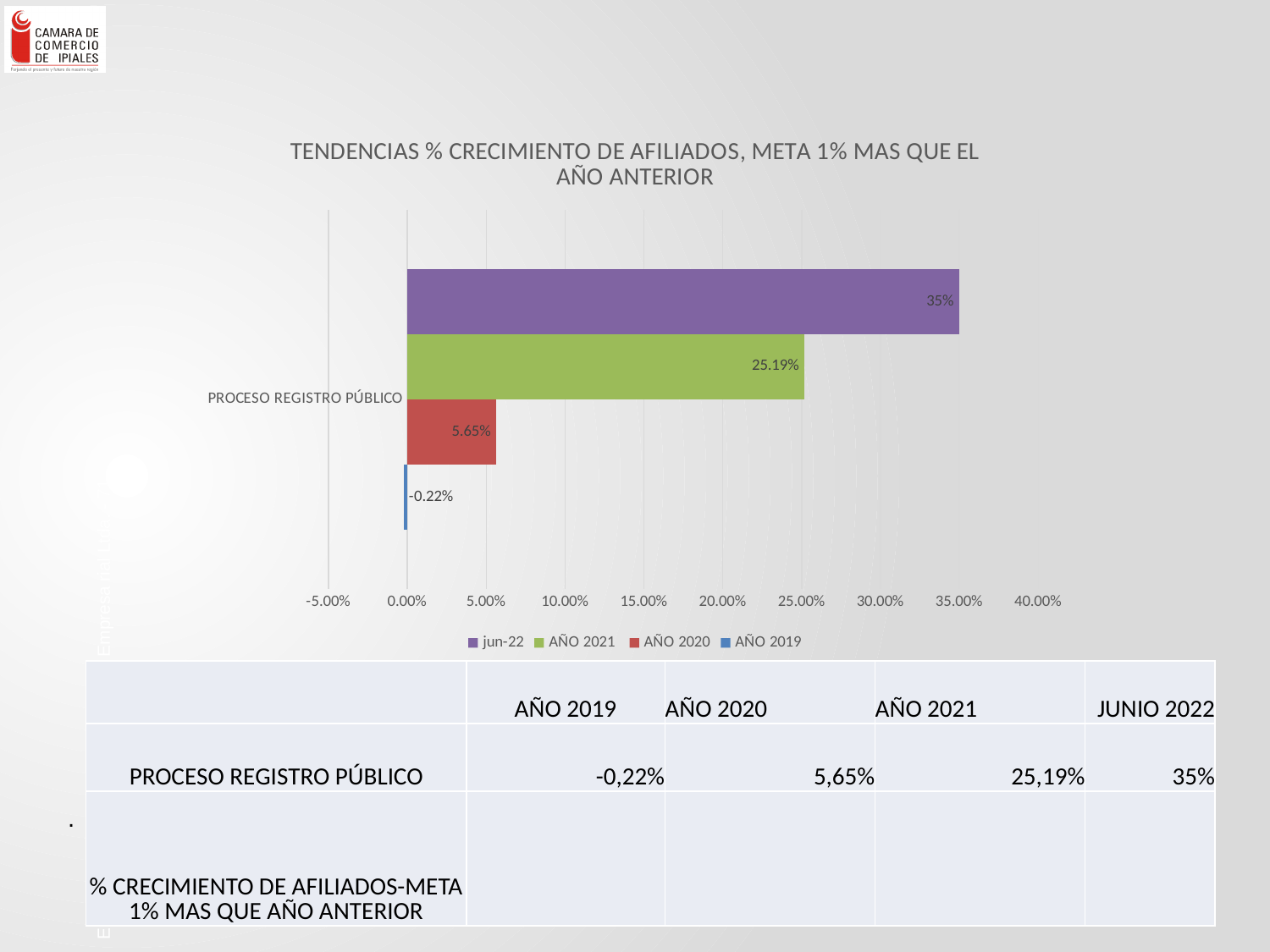
Which is larger, the value for AÑO 2020 or the value for AÑO 2021? AÑO 2021 What is the difference between the jun-22 value and the AÑO 2021 value? 9.81% What is the name of the single category shown on the chart's vertical axis? PROCESO REGISTRO PÚBLICO What is the value for the AÑO 2020 series in the chart? 5.65% What kind of chart is shown on the slide? Bar chart How many series does the legend list? 4 Which series has the highest value in the chart? jun-22 What is the title of the chart? TENDENCIAS % CRECIMIENTO DE AFILIADOS, META 1% MAS QUE EL AÑO ANTERIOR What is the value for the jun-22 series in the chart? 35% Which series has the lowest value in the chart? AÑO 2019 What is the value for the AÑO 2021 series in the chart? 25.19% What is the value for the AÑO 2019 series in the chart? -0.22%